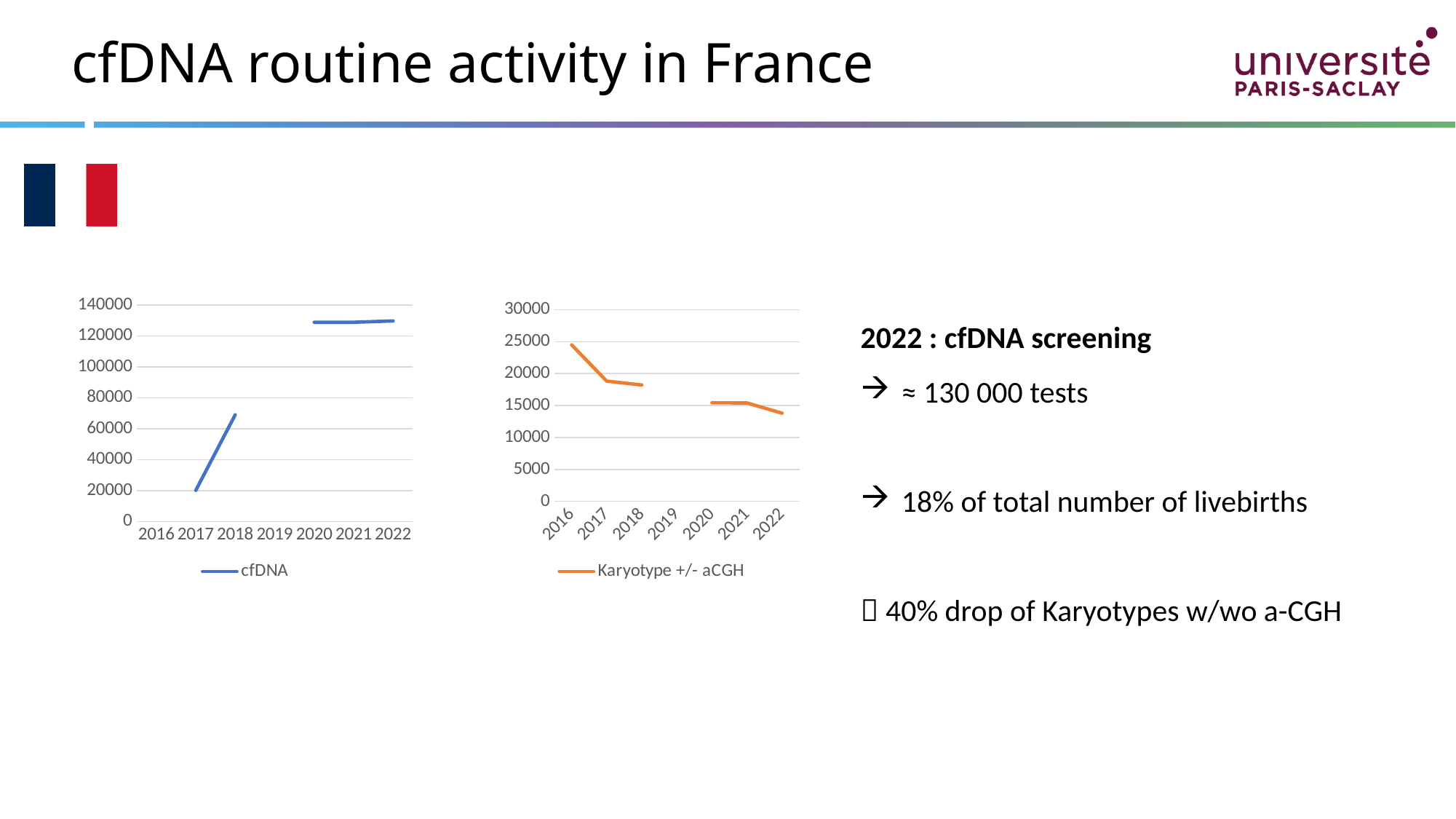
In the left cfDNA chart, is the value for 2022 greater or less than 120000? greater In the left cfDNA chart, is the value for 2018 greater or less than 60000? greater In the left cfDNA chart, is the value for 2017 greater or less than 40000? less In the left cfDNA chart, how many years are labelled on the x axis? 7 In the right Karyotype +/- aCGH chart, do the values generally rise or fall from 2016 to 2022? fall In the left cfDNA chart, how many series does the legend list? 1 In the right Karyotype +/- aCGH chart, which year has the highest value? 2016 In the right chart, what is the name of the series shown in the legend? Karyotype +/- aCGH What kind of chart is the left chart with the cfDNA legend? line chart What kind of chart is the right chart with the Karyotype +/- aCGH legend? line chart In the right Karyotype +/- aCGH chart, which year has the lowest value? 2022